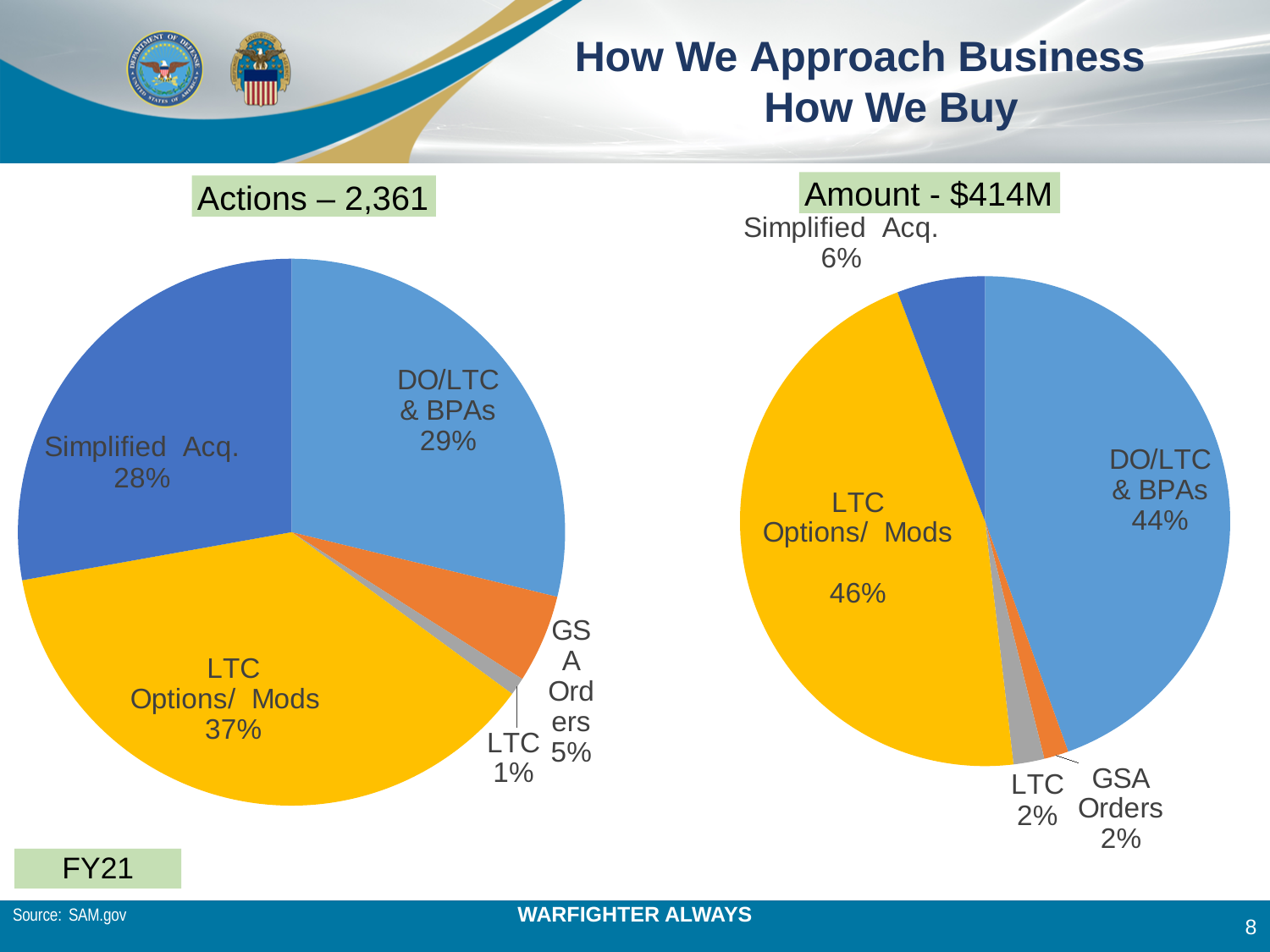
In the Amount - $414M chart, which category has the largest share? LTC Options/ Mods In the Actions – 2,361 chart, which category has the smallest share? LTC In the Actions – 2,361 chart, how many categories are shown? 5 What type of chart is the Amount - $414M chart? Pie chart In the Amount - $414M chart, what share is DO/LTC & BPAs? 44% In the Actions – 2,361 chart, what share is LTC Options/ Mods? 37% In the Actions – 2,361 chart, what share is GSA Orders? 5% Which is larger: the share of Simplified Acq. in the Actions – 2,361 chart or in the Amount - $414M chart? Actions – 2,361 chart In the Actions – 2,361 chart, which category has the largest share? LTC Options/ Mods In the Amount - $414M chart, what is the difference in percentage points between LTC Options/ Mods and DO/LTC & BPAs? 2 percentage points